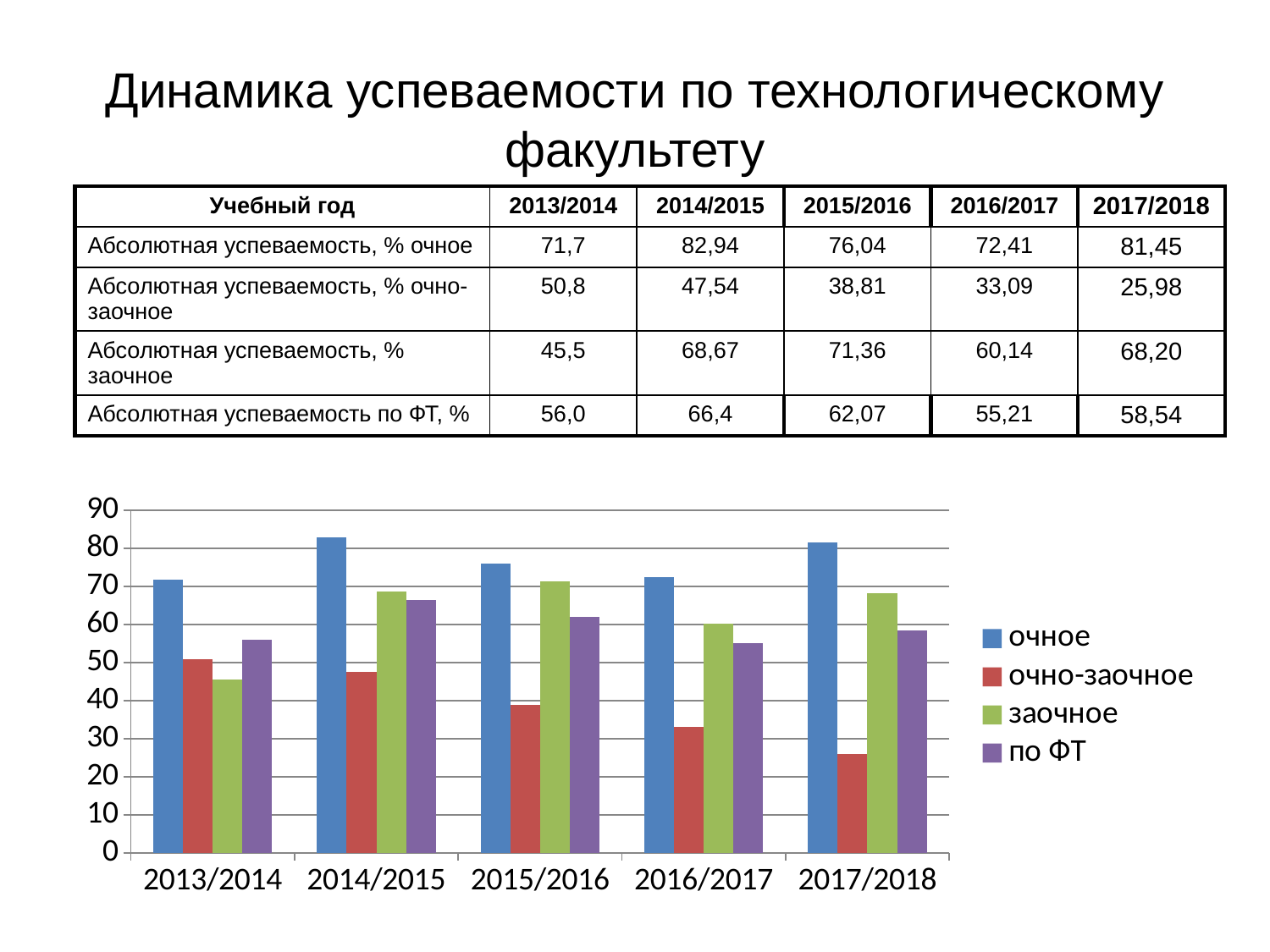
In 2013/2014, which is larger: the очное value or the заочное value? очное What is the по ФТ value for 2015/2016, as given in the table on the slide? 62,07 Is the очное value for 2014/2015 greater or less than 80? greater How many academic years are shown on the x axis of the chart? 5 Is the по ФТ value for 2016/2017 greater or less than 60? less Which series has the lowest bar in the 2013/2014 group? заочное In which academic year is the очно-заочное bar the lowest? 2017/2018 Is the заочное value for 2013/2014 greater or less than 50? less Which colour represents the заочное series in the chart legend? green Do the очно-заочное values rise or fall from 2013/2014 to 2017/2018? fall What kind of chart is shown on the slide? bar chart How many series does the chart legend list? 4